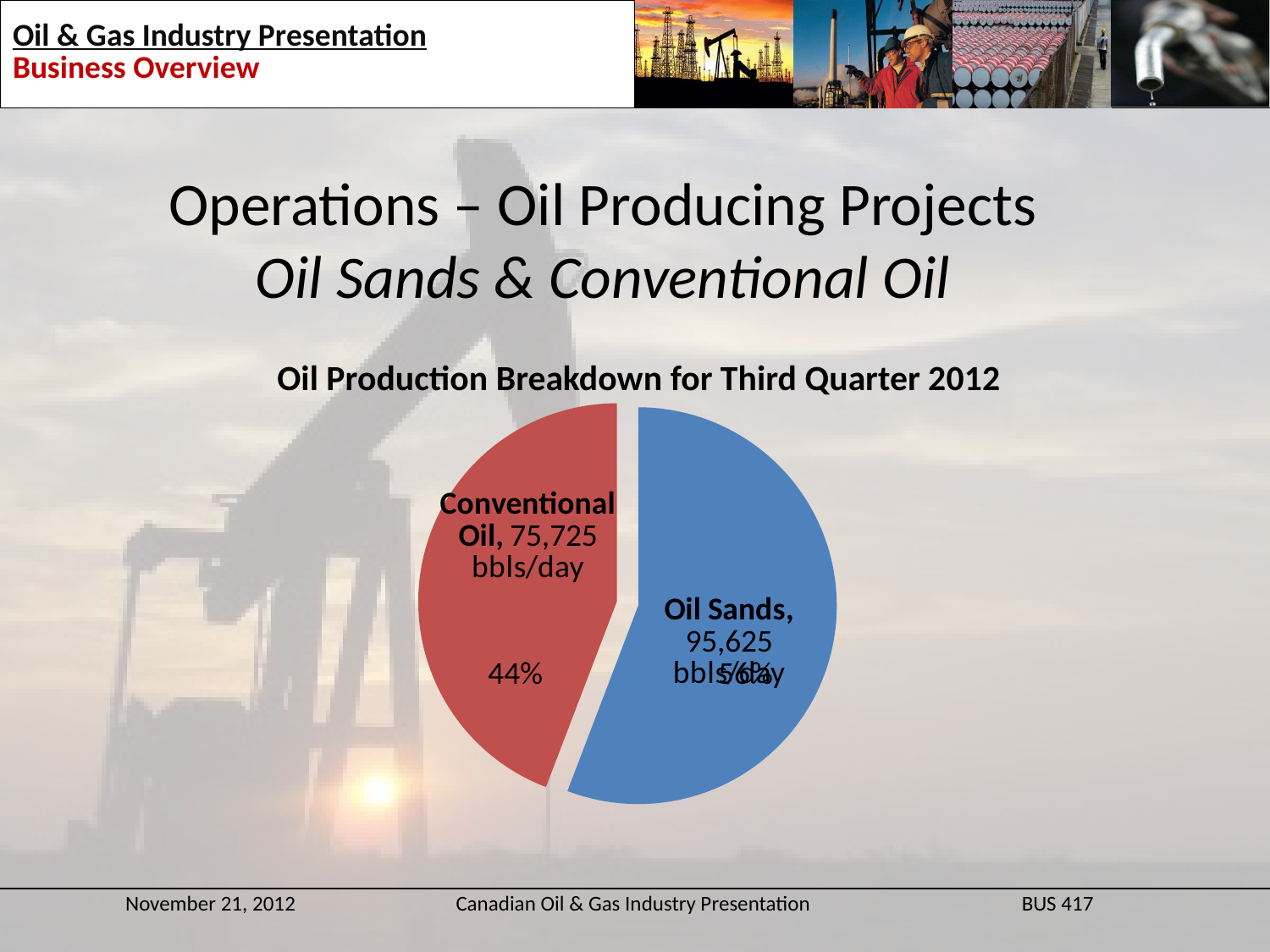
How many slices does the pie chart have? 2 What is the title of the chart? Oil Production Breakdown for Third Quarter 2012 What is the production value for Oil Sands? 95,625 bbls/day What is the difference in production between Oil Sands and Conventional Oil? 19,900 bbls/day What kind of chart is shown on the slide? pie chart Which category has the larger share of oil production? Oil Sands Which is larger, the production for Oil Sands or for Conventional Oil? Oil Sands What is the production value for Conventional Oil? 75,725 bbls/day What share of the pie does Conventional Oil represent? 44% Which category has the smaller share of oil production? Conventional Oil What is the total oil production shown in the pie chart? 171,350 bbls/day What colour is the Oil Sands slice? blue